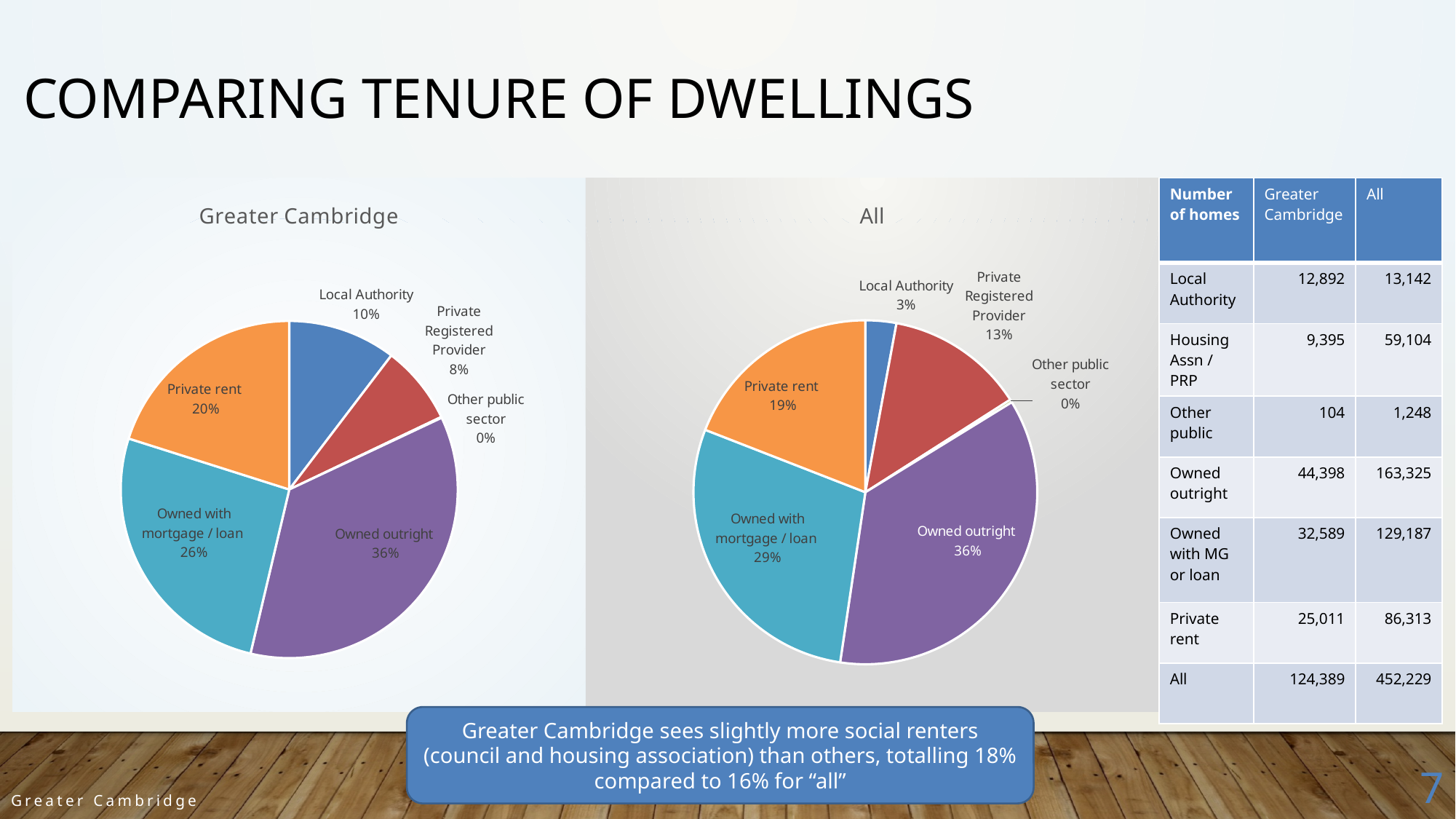
In the Greater Cambridge pie chart, what share is Owned outright? 36% In the Greater Cambridge pie chart, which category has the largest share? Owned outright In the All pie chart, which is larger: Private rent or Private Registered Provider? Private rent In the Greater Cambridge pie chart, what share is Local Authority? 10% In the All pie chart, what share is Private Registered Provider? 13% What is the title of the left pie chart? Greater Cambridge In the All pie chart, which category has the smallest share? Other public sector In the Greater Cambridge pie chart, what is the difference between the Owned with mortgage / loan share and the Private rent share? 6% In the Greater Cambridge pie chart, what is the combined share of Local Authority and Private Registered Provider? 18% What kind of chart is the All chart? Pie chart How many categories does the Greater Cambridge pie chart show? 6 In the All pie chart, what share is Owned with mortgage / loan? 29%